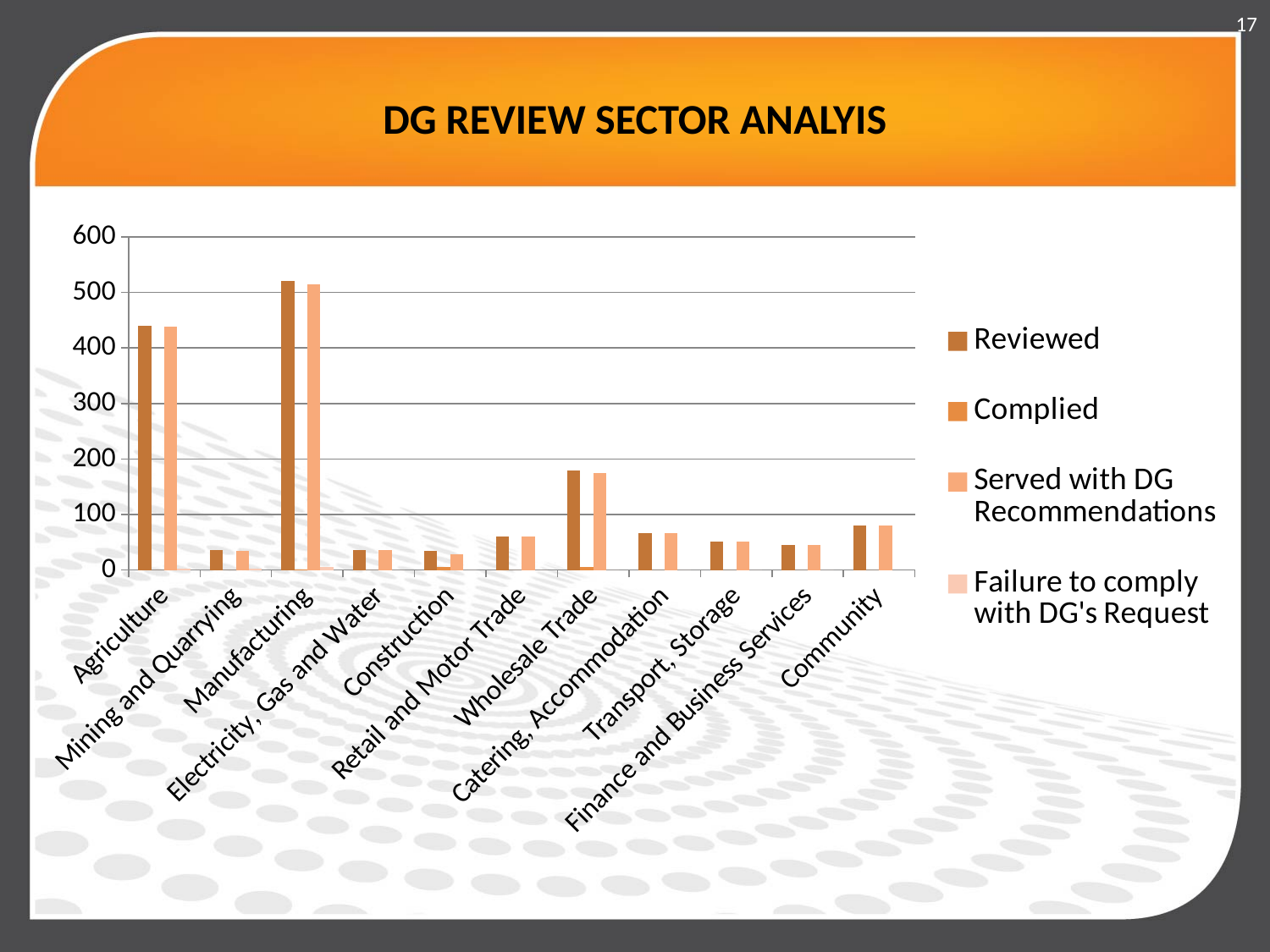
What is the title of the slide? DG REVIEW SECTOR ANALYIS Which has the larger Reviewed value, Manufacturing or Agriculture? Manufacturing Is the Reviewed value for Community greater or less than 100? less Is the Reviewed value for Wholesale Trade greater or less than 200? less Is the Reviewed value for Agriculture greater or less than 400? greater Which sector has the highest Reviewed value? Manufacturing Which has the larger Reviewed value, Wholesale Trade or Community? Wholesale Trade How many series does the legend list? 4 What is the last series listed in the legend? Failure to comply with DG's Request How many sector categories are shown on the x axis? 11 What kind of chart is shown on the slide? bar chart